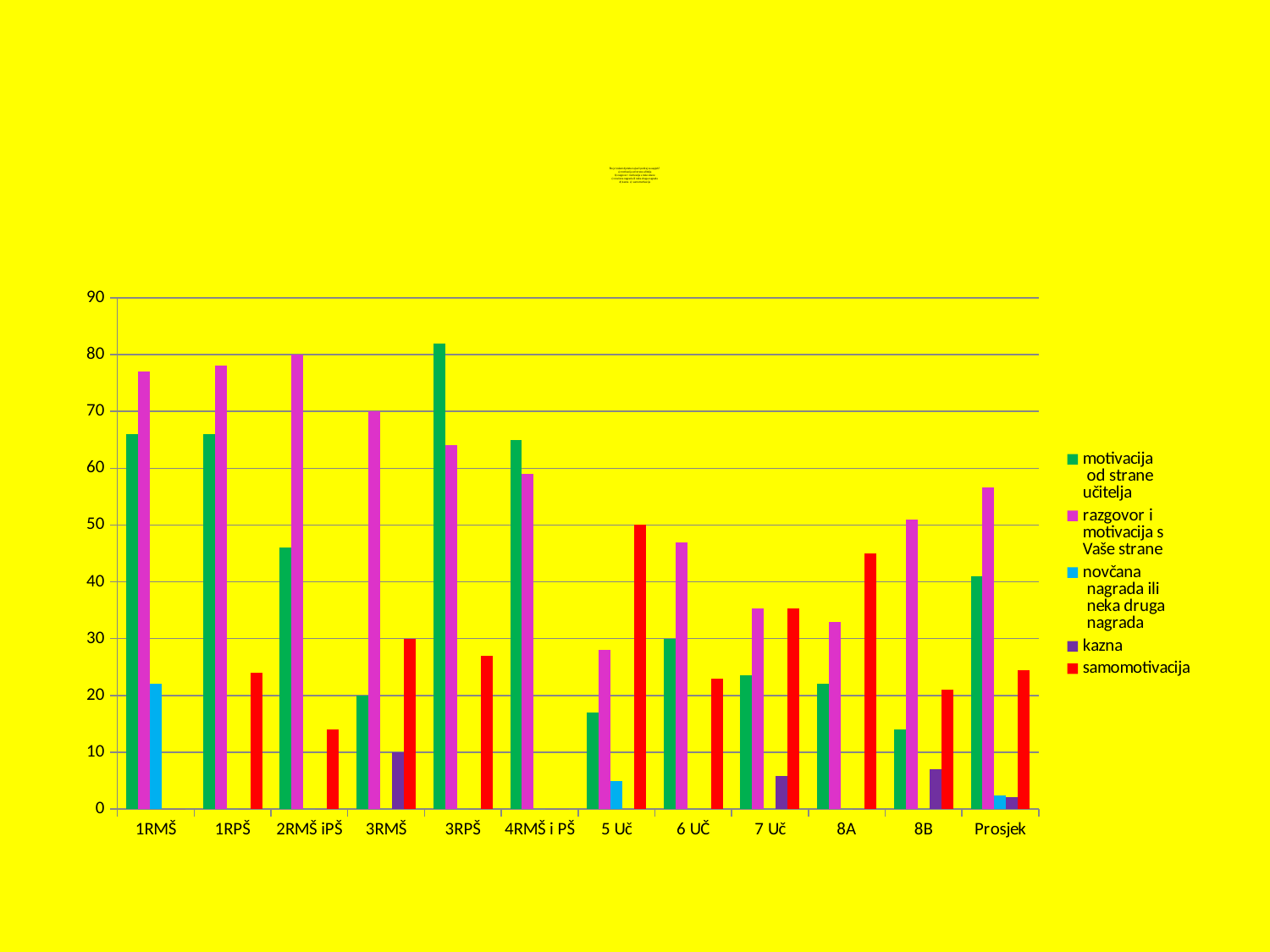
How many categories are shown along the x axis? 12 Which category has the tallest bar for 'motivacija od strane učitelja'? 3RPŠ Which category has the lowest 'razgovor i motivacija s Vaše strane' bar? 5 Uč For 1RMŠ, which is larger: 'motivacija od strane učitelja' or 'razgovor i motivacija s Vaše strane'? razgovor i motivacija s Vaše strane Is the value of 'motivacija od strane učitelja' for 8B greater or less than 20? less Is the value of 'samomotivacija' for 8A greater or less than 40? greater What is the value of 'kazna' for 3RMŠ? 10 How many series does the legend list? 5 What kind of chart is shown on the slide? bar chart What is the value of 'samomotivacija' for 5 Uč? 50 What is the value of 'razgovor i motivacija s Vaše strane' for 2RMŠ iPŠ? 80 What colour represents 'samomotivacija' in the legend? red